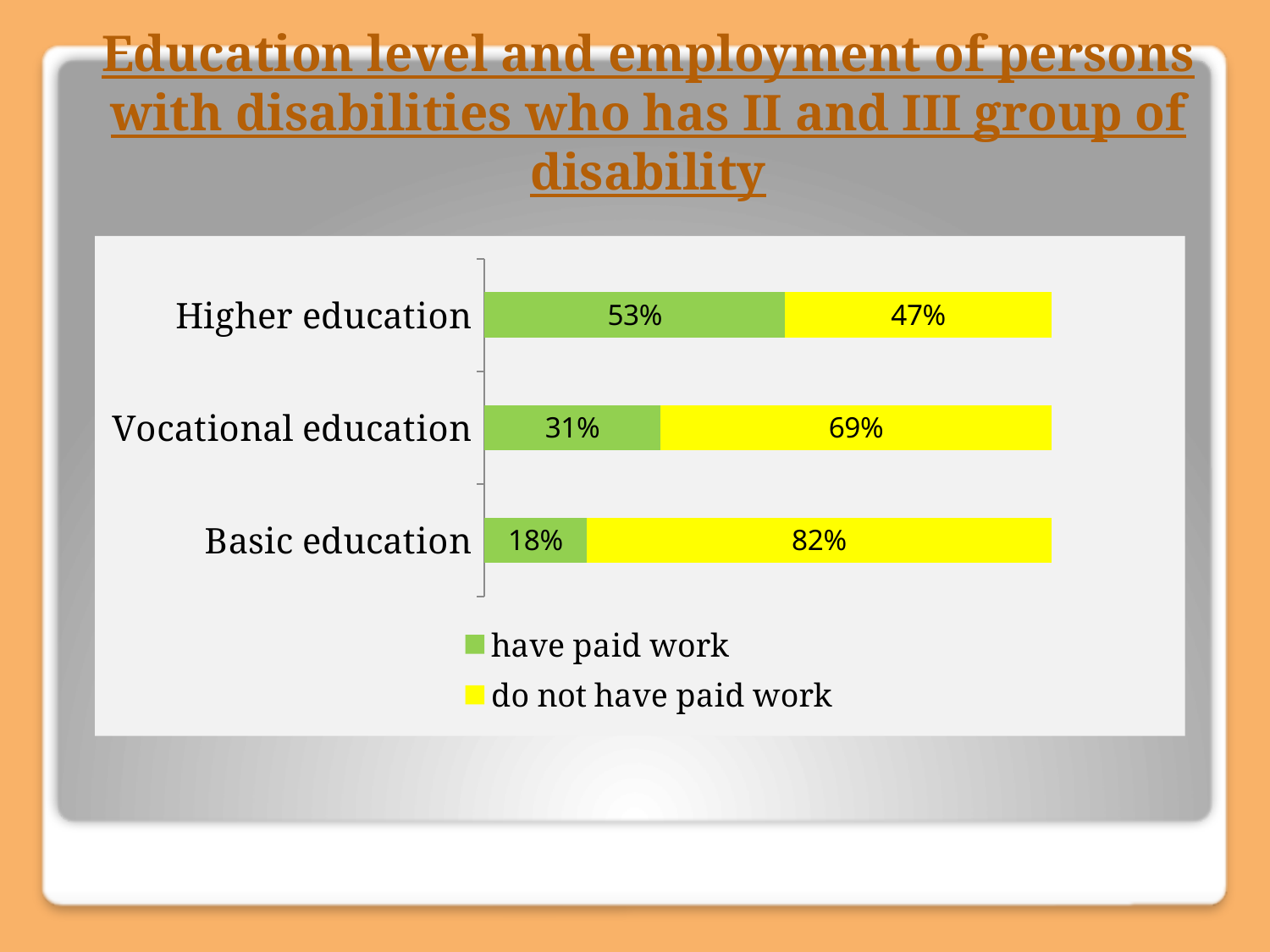
What is the difference between the 'have paid work' shares for higher education and basic education? 35% Which is larger: the 'do not have paid work' share for vocational education or for higher education? Vocational education What is the total of the stacked bar for vocational education? 100% What percentage of persons with higher education have paid work? 53% Which colour represents 'do not have paid work' in the chart? Yellow How many series does the legend list? 2 Which education level has the highest share of persons who have paid work? Higher education How many education levels are shown in the chart? 3 What percentage of persons with basic education do not have paid work? 82% What kind of chart is shown on the slide? Stacked bar chart What percentage of persons with vocational education have paid work? 31% Which education level has the lowest share of persons who have paid work? Basic education